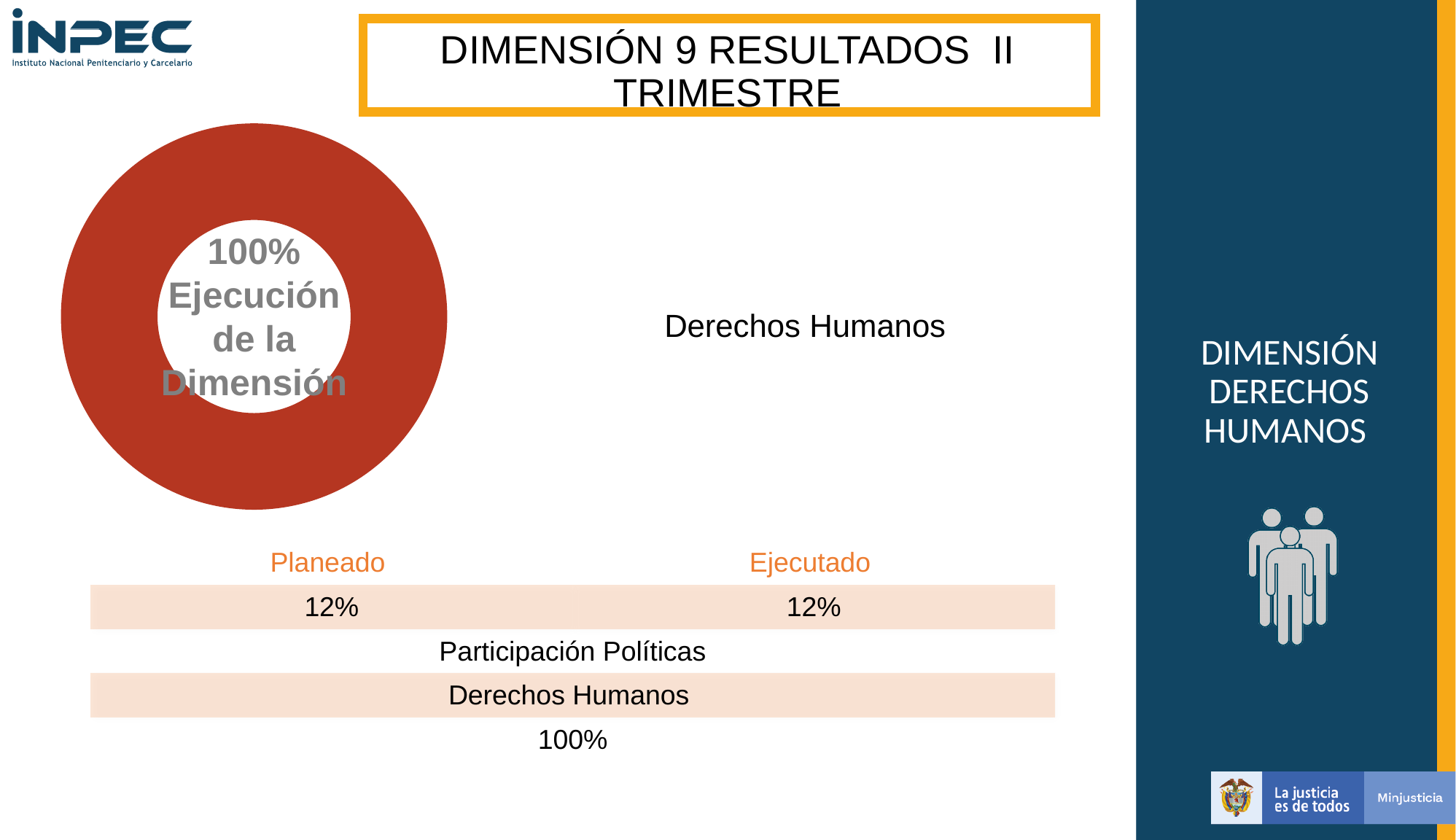
What text accompanies the percentage in the centre of the doughnut chart? Ejecución de la Dimensión What percentage is printed in the centre of the doughnut chart? 100% What label appears to the right of the doughnut chart? Derechos Humanos Is the value shown in the doughnut chart greater or less than 50%? greater What kind of chart is shown on the left of the slide? Doughnut (pie) chart What share of the doughnut chart does the single red slice occupy? 100% What colour is the slice of the doughnut chart? Red How many slices does the doughnut chart contain? 1